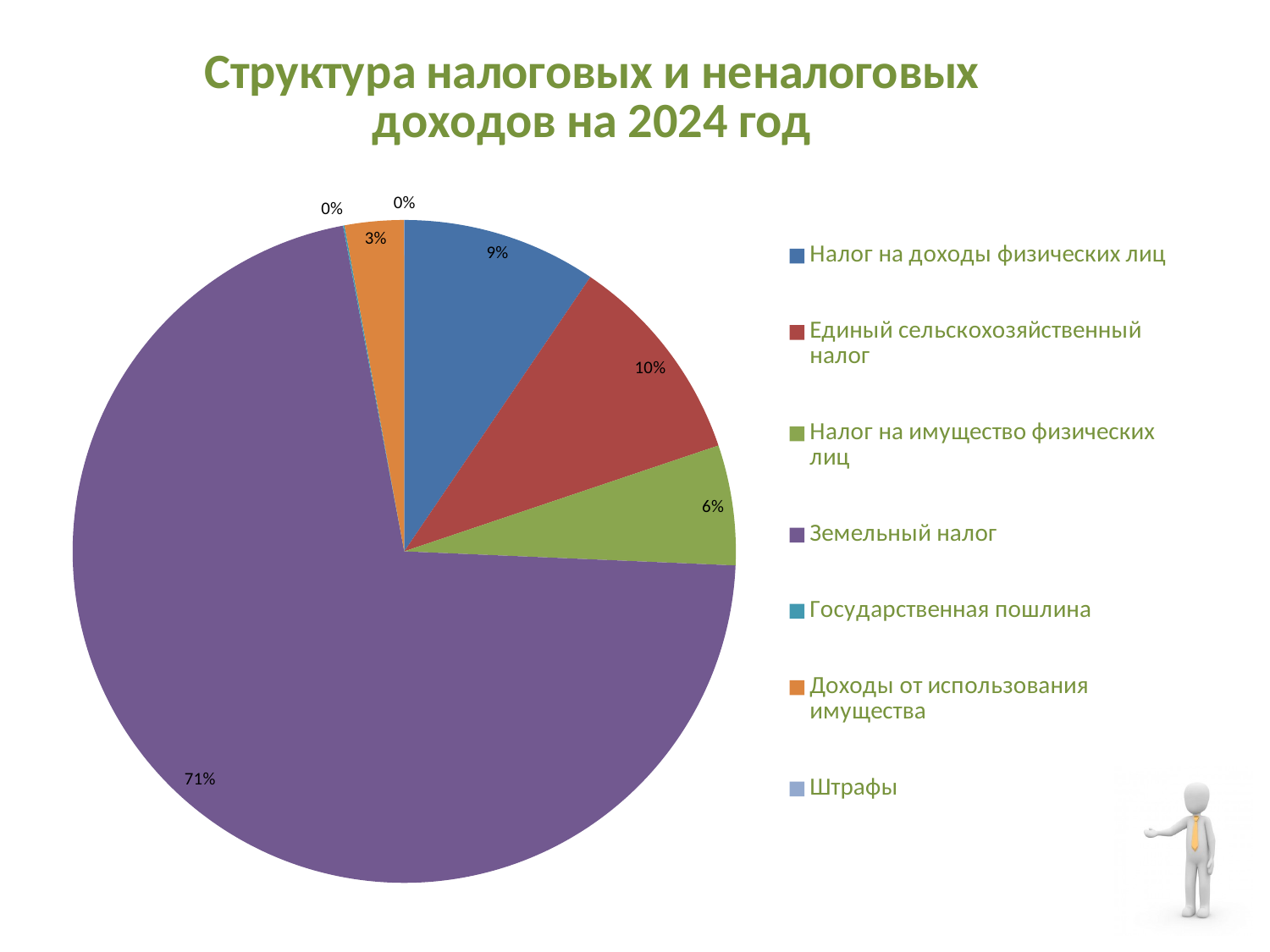
What is the title of the chart on the slide? Структура налоговых и неналоговых доходов на 2024 год How many categories does the legend of the pie chart list? 7 What share of the pie does Единый сельскохозяйственный налог have? 10% What share of the pie does Земельный налог have? 71% Which is larger: the share of Единый сельскохозяйственный налог or the share of Налог на имущество физических лиц? Единый сельскохозяйственный налог What is the difference between the share of Земельный налог and the share of Единый сельскохозяйственный налог? 61% What share of the pie does Налог на имущество физических лиц have? 6% What kind of chart is shown on the slide? pie chart What share of the pie does Налог на доходы физических лиц have? 9% What share of the pie does Доходы от использования имущества have? 3% Which category has the largest slice of the pie? Земельный налог What colour is the slice for Земельный налог? purple